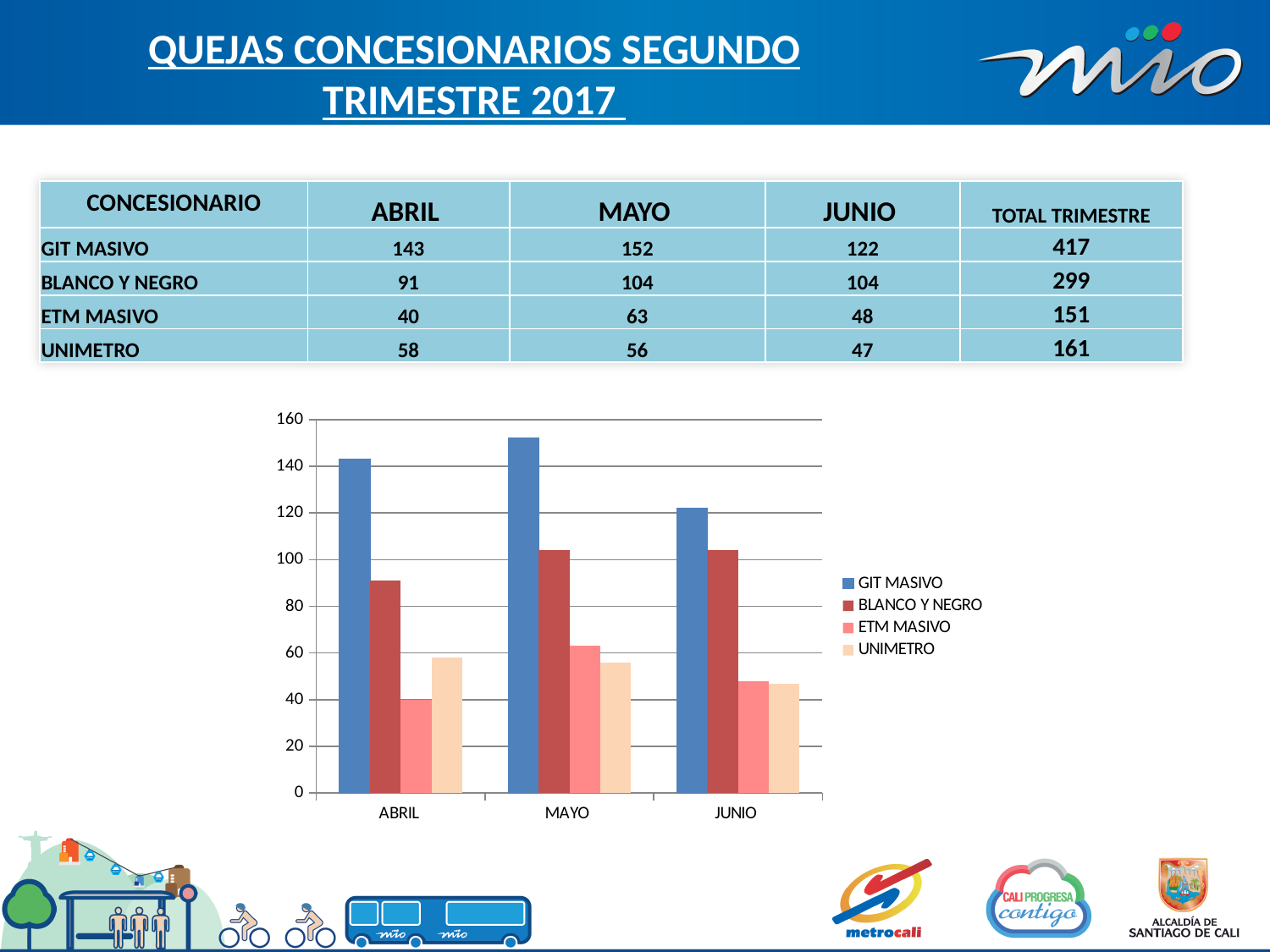
How many month categories are shown on the x axis of the chart? 3 What is the value for UNIMETRO in JUNIO? 47 Is the value for GIT MASIVO in JUNIO greater or less than 140? less How many series does the chart legend list? 4 What kind of chart is shown on the slide? bar chart What is the value for ETM MASIVO in ABRIL? 40 What is the value for GIT MASIVO in MAYO? 152 In which month is the GIT MASIVO bar highest? MAYO What is the difference between GIT MASIVO and BLANCO Y NEGRO in ABRIL? 52 Do the GIT MASIVO values rise or fall from MAYO to JUNIO? fall Which is larger in MAYO, ETM MASIVO or UNIMETRO? ETM MASIVO Which series has the lowest bar in ABRIL? ETM MASIVO